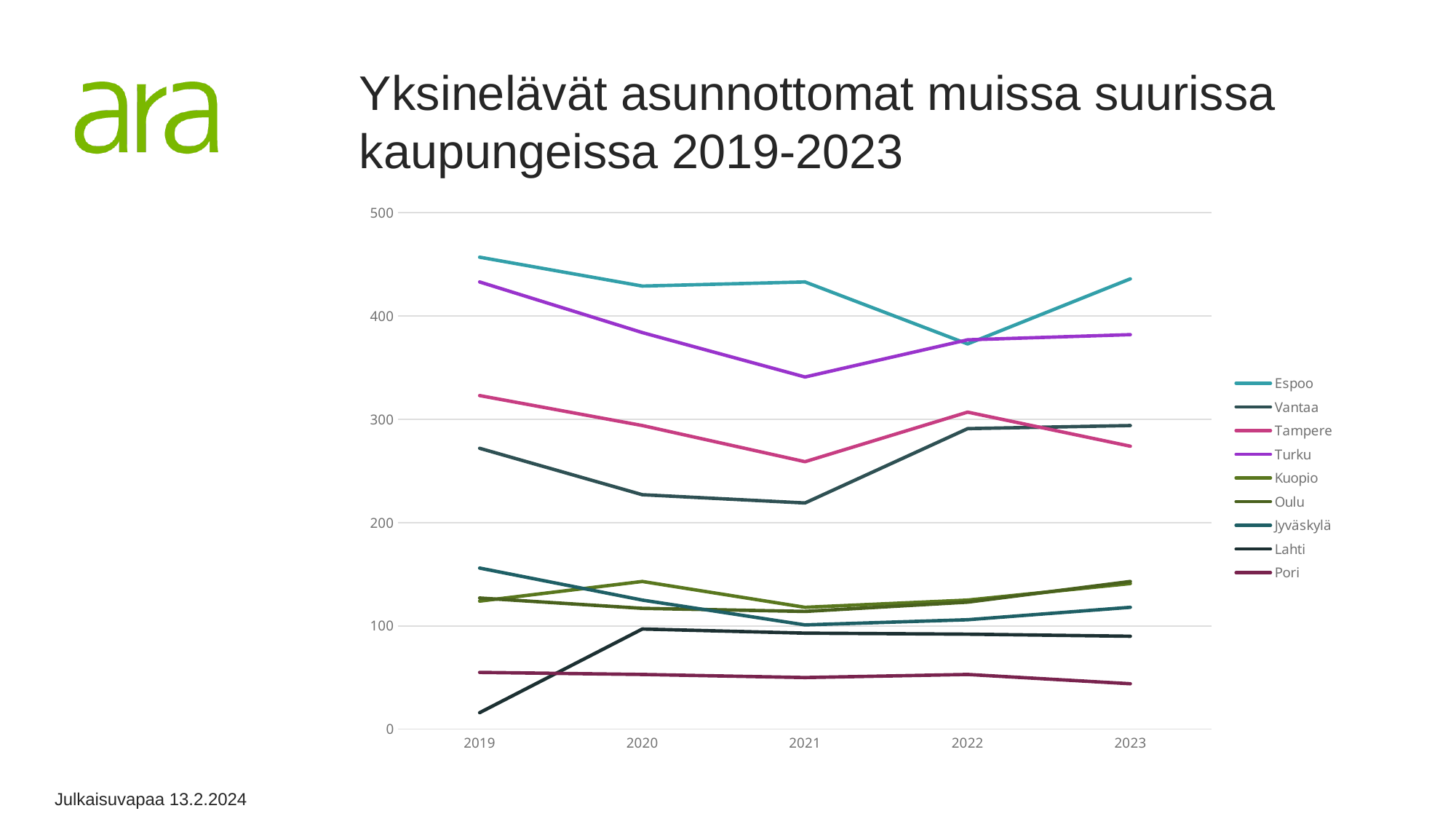
Does the value for Turku rise or fall from 2019 to 2021? fall Which is larger in 2023, the value for Espoo or the value for Turku? Espoo How many series does the legend list? 9 Is the value for Vantaa in 2020 greater or less than 300? less Is the value for Espoo in 2019 greater or less than 400? greater Which city has the lowest value in 2023? Pori Which city has the highest value in 2019? Espoo How many years are shown on the x axis? 5 What kind of chart is shown on the slide? line chart Which city has the lowest value in 2019? Lahti Which is larger in 2021, the value for Tampere or the value for Vantaa? Tampere Which city is shown by the purple line? Turku